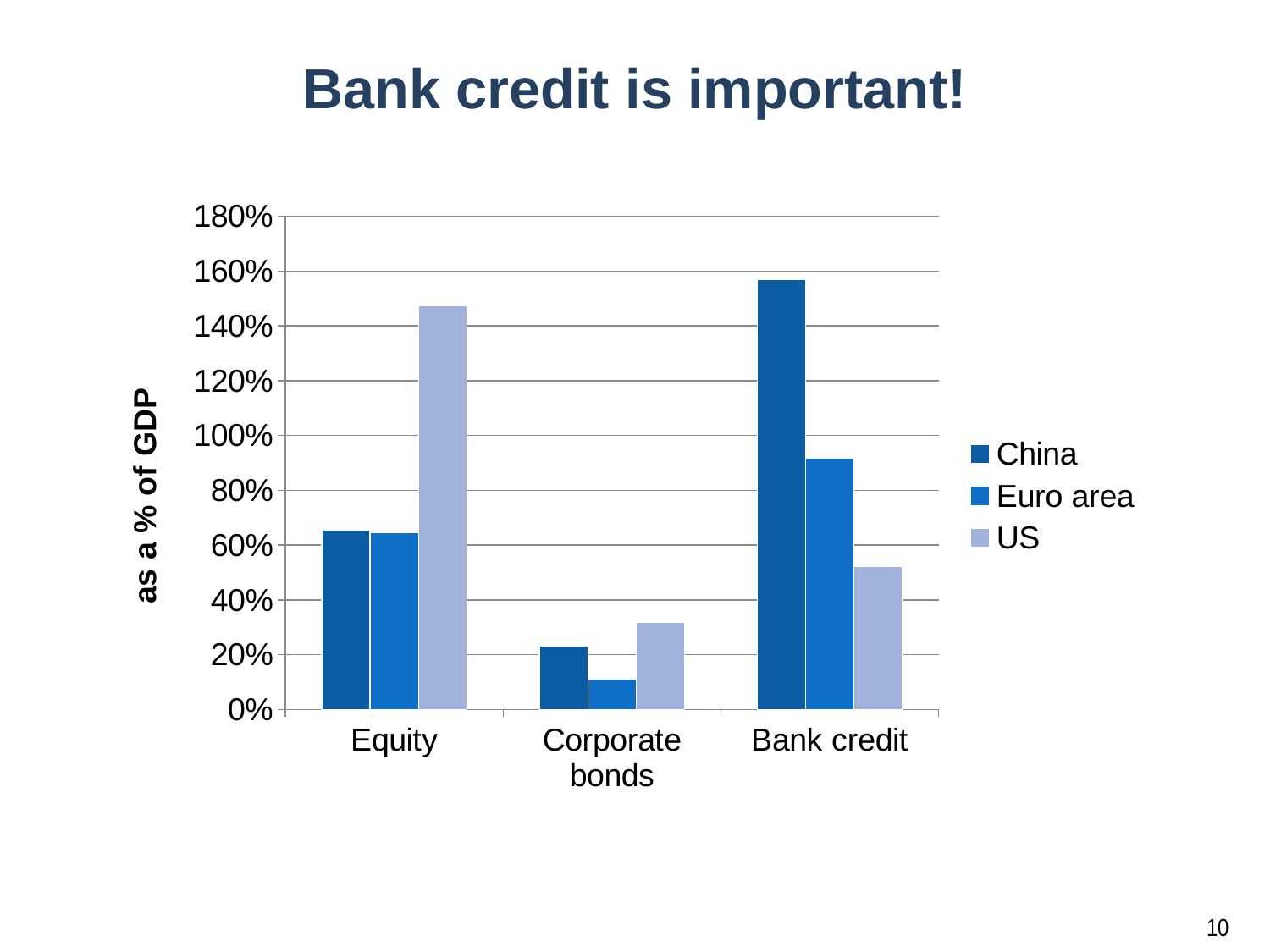
Which series has the lowest value for Bank credit? US What is the label on the vertical axis? as a % of GDP What kind of chart is shown on the slide? bar chart Is the value for China in Bank credit greater or less than 140%? greater Which series has the highest value for Equity? US Is the value for US in Equity greater or less than 120%? greater How many series does the legend list? 3 For Bank credit, which is larger: the value for Euro area or the value for US? Euro area Which series has the lowest value for Corporate bonds? Euro area Is the value for Euro area in Corporate bonds greater or less than 20%? less How many categories are shown on the x axis? 3 Which series has the highest value for Bank credit? China